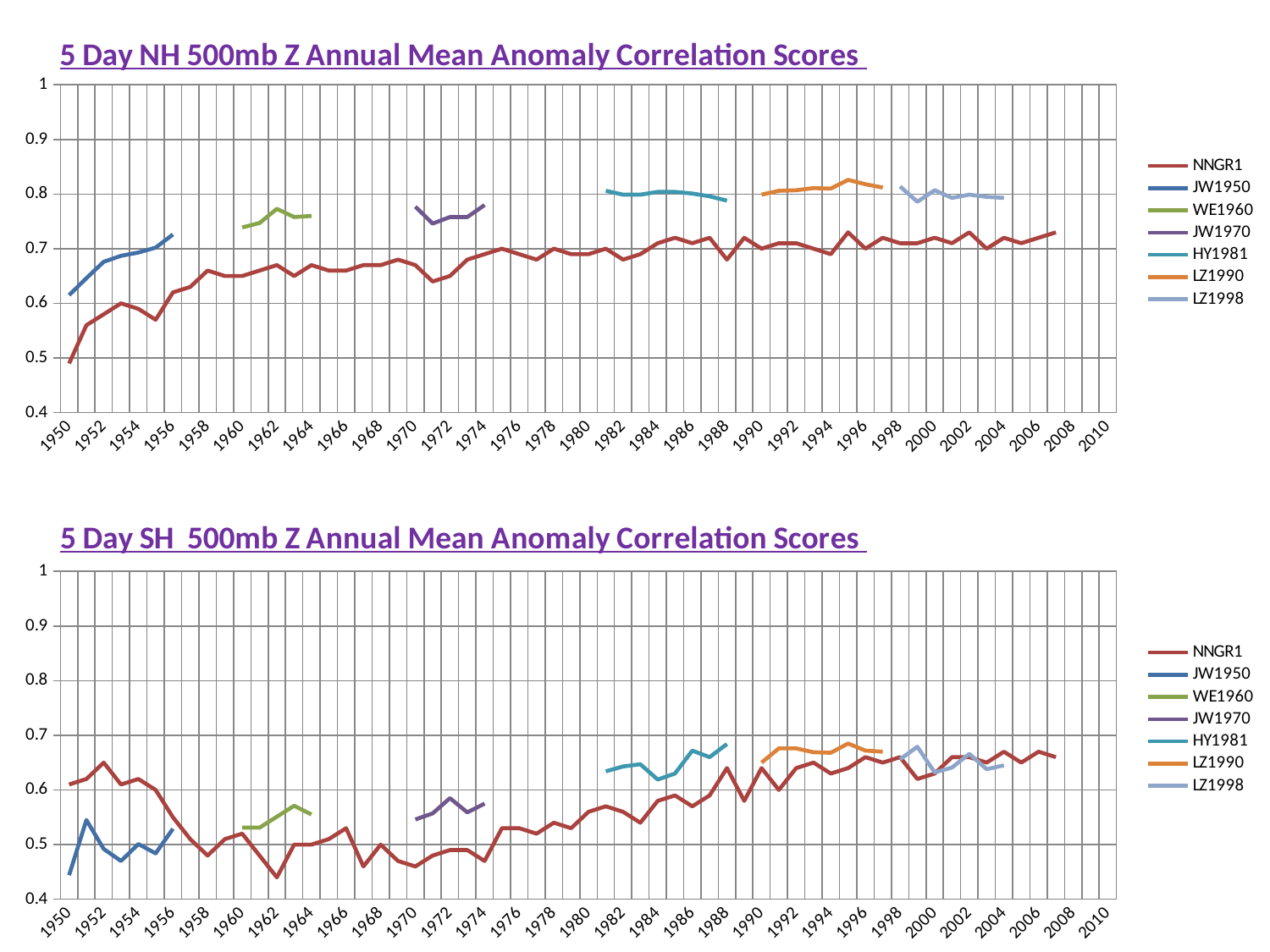
In the '5 Day NH 500mb Z Annual Mean Anomaly Correlation Scores' chart, which series is listed first in the legend? NNGR1 In the '5 Day NH 500mb Z Annual Mean Anomaly Correlation Scores' chart, does the NNGR1 series generally rise or fall from 1950 to 2007? rise In the '5 Day NH 500mb Z Annual Mean Anomaly Correlation Scores' chart, is the NNGR1 value for 1950 greater or less than 0.6? less In the '5 Day SH 500mb Z Annual Mean Anomaly Correlation Scores' chart, which series is listed last in the legend? LZ1998 How many series does the legend of the '5 Day SH 500mb Z Annual Mean Anomaly Correlation Scores' chart list? 7 In the '5 Day SH 500mb Z Annual Mean Anomaly Correlation Scores' chart, which series has the larger value in 1951, NNGR1 or JW1950? NNGR1 In the '5 Day NH 500mb Z Annual Mean Anomaly Correlation Scores' chart, is the JW1950 value for 1950 greater or less than 0.7? less What kind of chart is the '5 Day NH 500mb Z Annual Mean Anomaly Correlation Scores' chart? line chart In the '5 Day SH 500mb Z Annual Mean Anomaly Correlation Scores' chart, is the LZ1990 value for 1995 greater or less than 0.7? less In the '5 Day NH 500mb Z Annual Mean Anomaly Correlation Scores' chart, which series has the larger value in 1995, LZ1990 or NNGR1? LZ1990